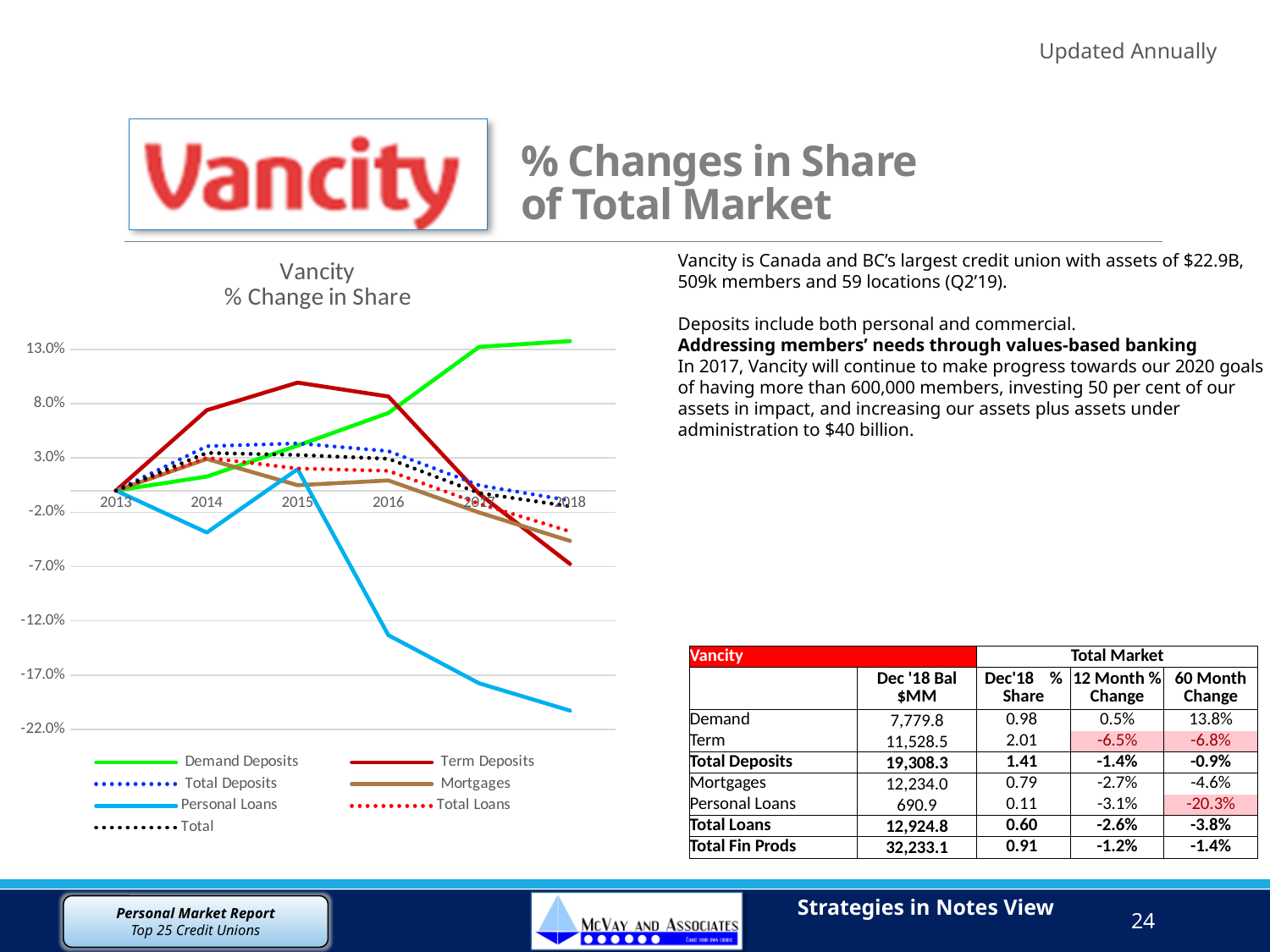
In the "Vancity % Change in Share" chart, which series has the highest value in 2018? Demand Deposits How many years are shown on the x axis of the "Vancity % Change in Share" chart? 6 In the "Vancity % Change in Share" chart, is the value for Personal Loans in 2018 greater or less than -17.0%? less In the "Vancity % Change in Share" chart, does the Demand Deposits line rise or fall from 2013 to 2018? Rise In the "Vancity % Change in Share" chart, which series has the lowest value in 2018? Personal Loans In the "Vancity % Change in Share" chart, does the Personal Loans line rise or fall from 2015 to 2018? Fall In the "Vancity % Change in Share" chart, is the value for Term Deposits in 2018 greater or less than -2.0%? less What kind of chart is the "Vancity % Change in Share" chart? Line chart In the "Vancity % Change in Share" chart, is the value for Term Deposits in 2015 greater or less than 8.0%? greater In the "Vancity % Change in Share" chart, which series has the highest value in 2015? Term Deposits How many series does the legend of the "Vancity % Change in Share" chart list? 7